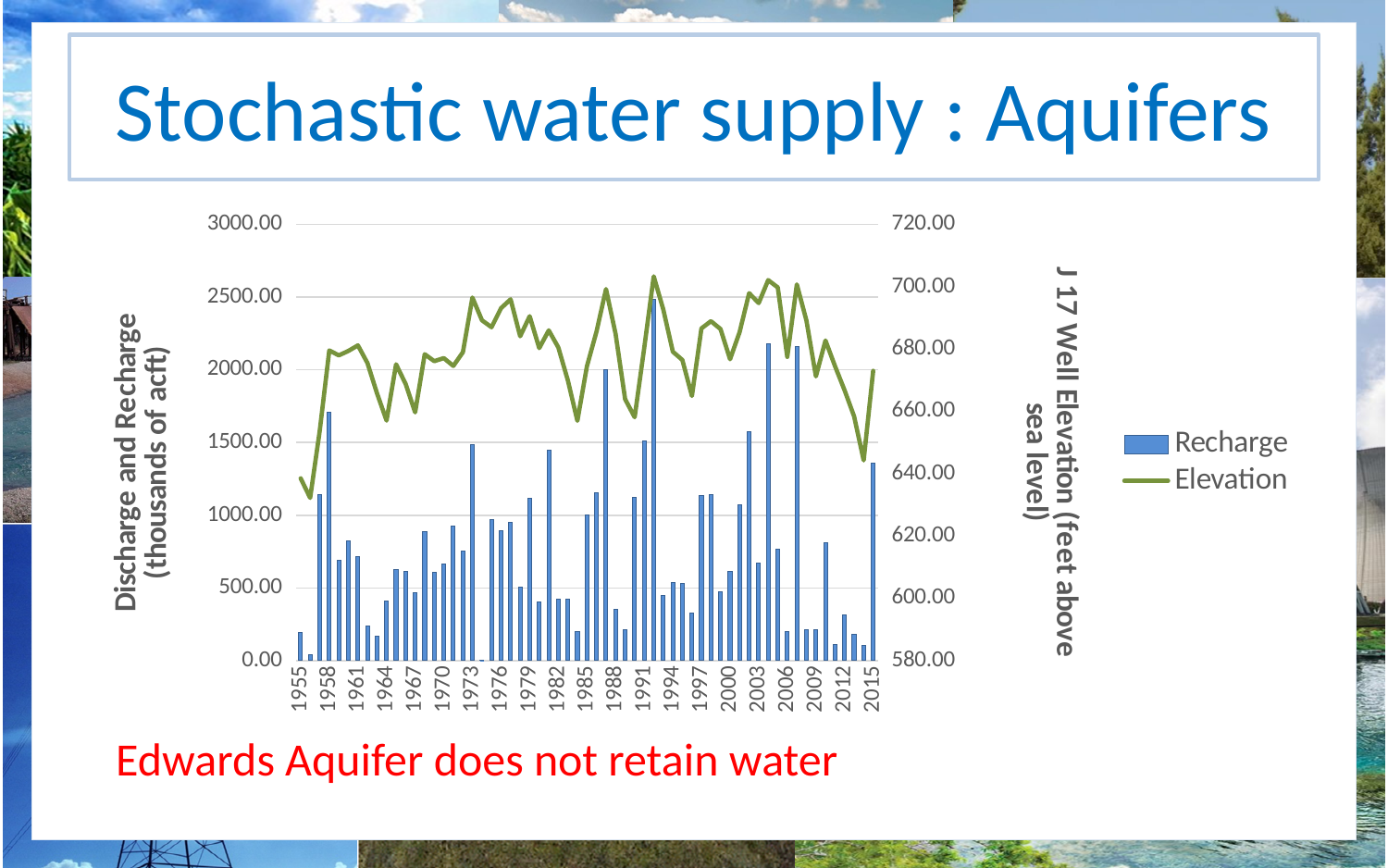
Is the Recharge value for 1997 greater or less than 1000? greater Which year has the higher Recharge value, 1955 or 1958? 1958 Is the Recharge value for 1958 greater or less than 1500? greater Does the Elevation line rise or fall between 2009 and 2013? fall Is the Elevation value for 1955 greater or less than 660? less How many series does the legend list? 2 Does the Elevation line rise or fall between 1955 and 1958? rise What kind of chart is shown on the slide? A combination bar and line chart Which series is drawn as a line? Elevation What is the title of the left vertical axis? Discharge and Recharge (thousands of acft)